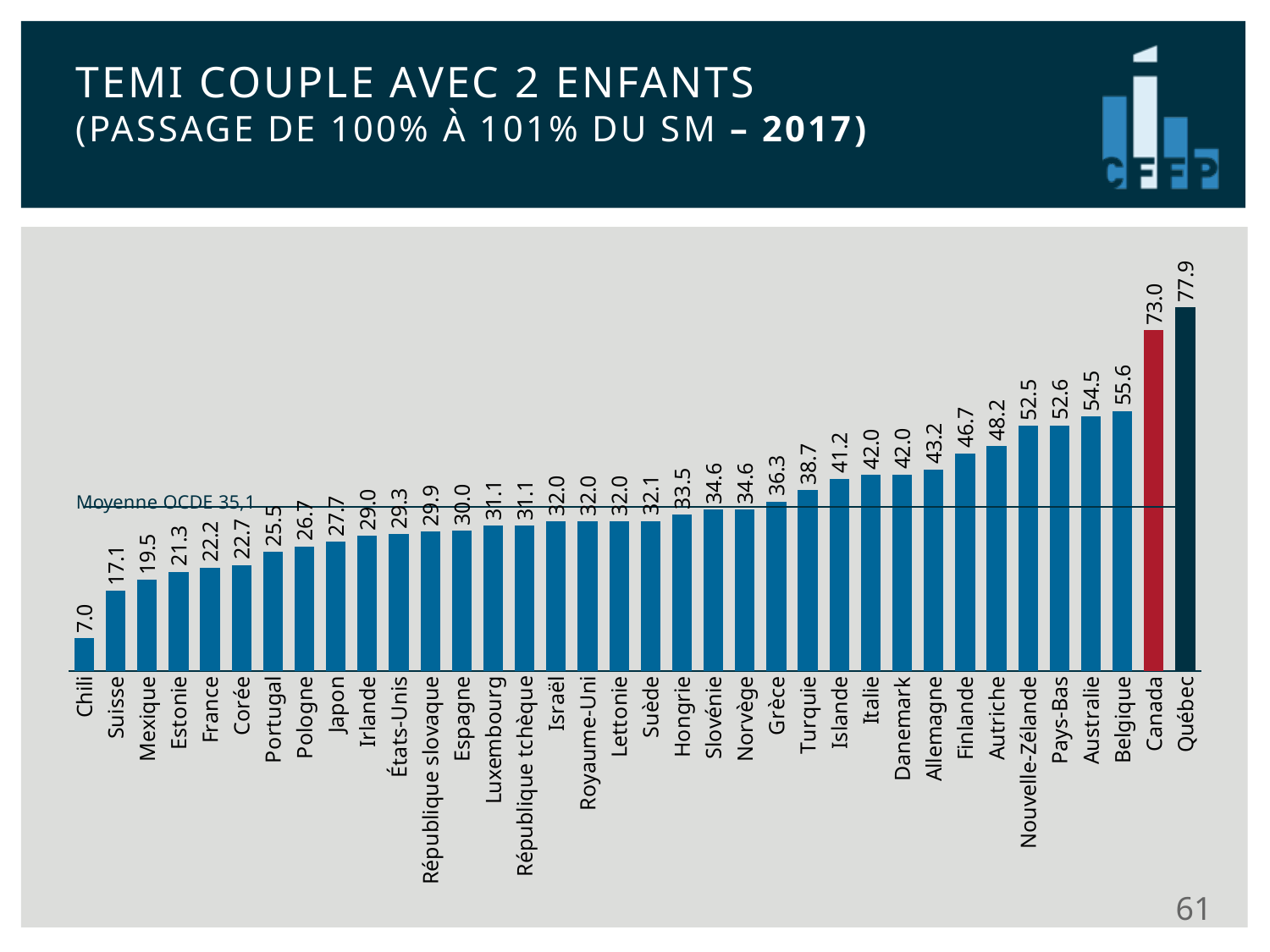
Which category has the highest value? Québec What is the difference between the values for Québec and Canada? 4.9 Which bar is coloured red? Canada What value is given for the Moyenne OCDE line? 35,1 What is the value for France? 22.2 What is the value for Canada? 73.0 Do the values rise or fall from left to right along the x axis? rise Which category has the lowest value? Chili Which is larger, the value for Australie or the value for Pays-Bas? Australie What kind of chart is this? bar chart How many categories are shown on the x axis? 36 What is the value for Belgique? 55.6